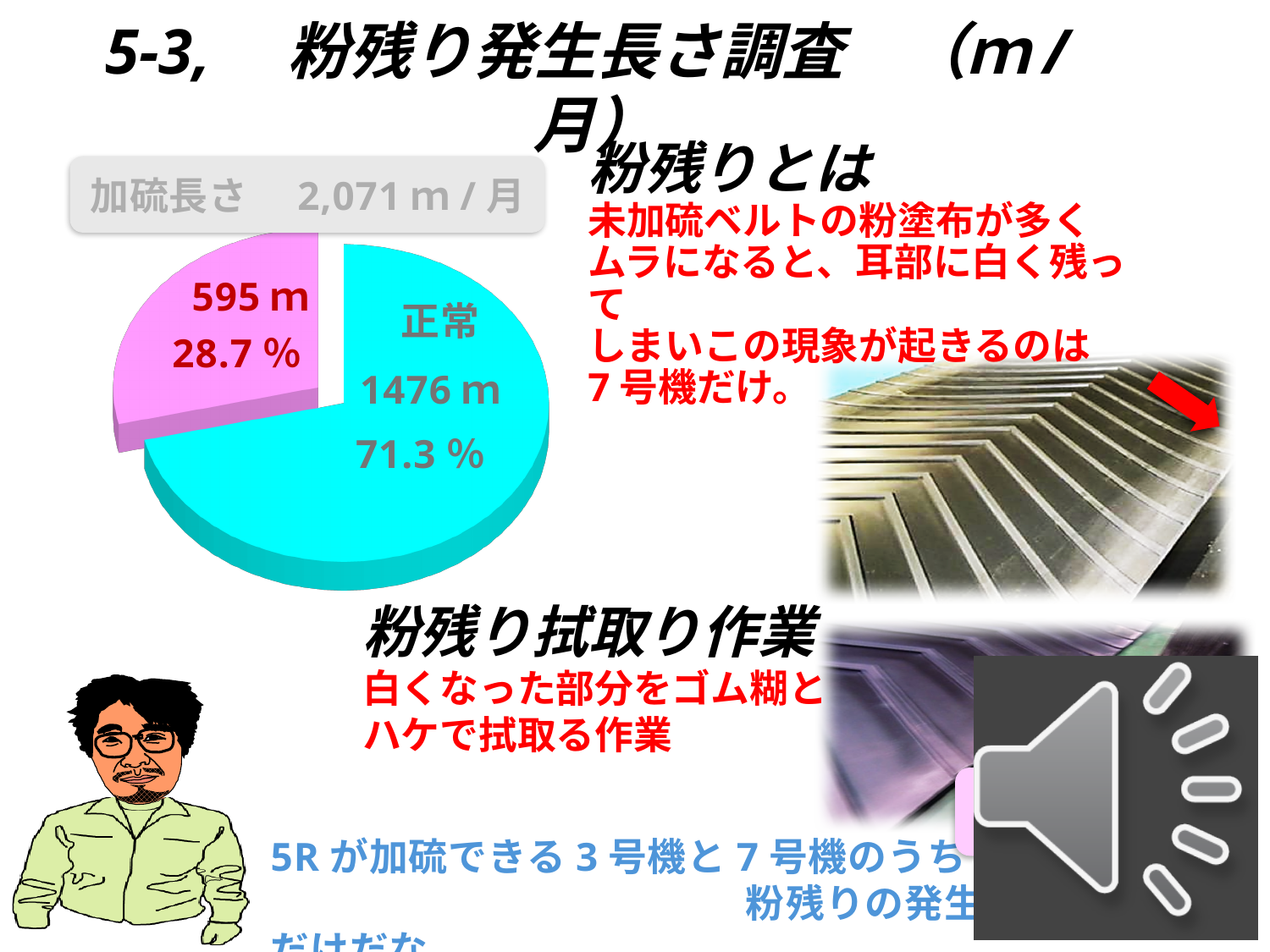
What is the difference in metres between the 正常 slice and the pink slice of the pie chart? 881 m What length in metres is shown for the 正常 slice of the pie chart? 1476 m What percentage is shown for the pink slice of the pie chart? 28.7 % How many slices does the pie chart have? 2 What colour is the 正常 slice of the pie chart? cyan What percentage is shown for the 正常 slice of the pie chart? 71.3 % What kind of chart is shown on the slide? pie chart Is the value for the 正常 slice of the pie chart greater or less than 1000 m? greater Which slice of the pie chart is larger, the 正常 slice or the pink slice? 正常 What total 加硫長さ per month is shown in the box above the pie chart? 2,071 m / 月 What length in metres is shown for the pink slice of the pie chart? 595 m Which slice of the pie chart is the smallest? the pink slice (595 m)